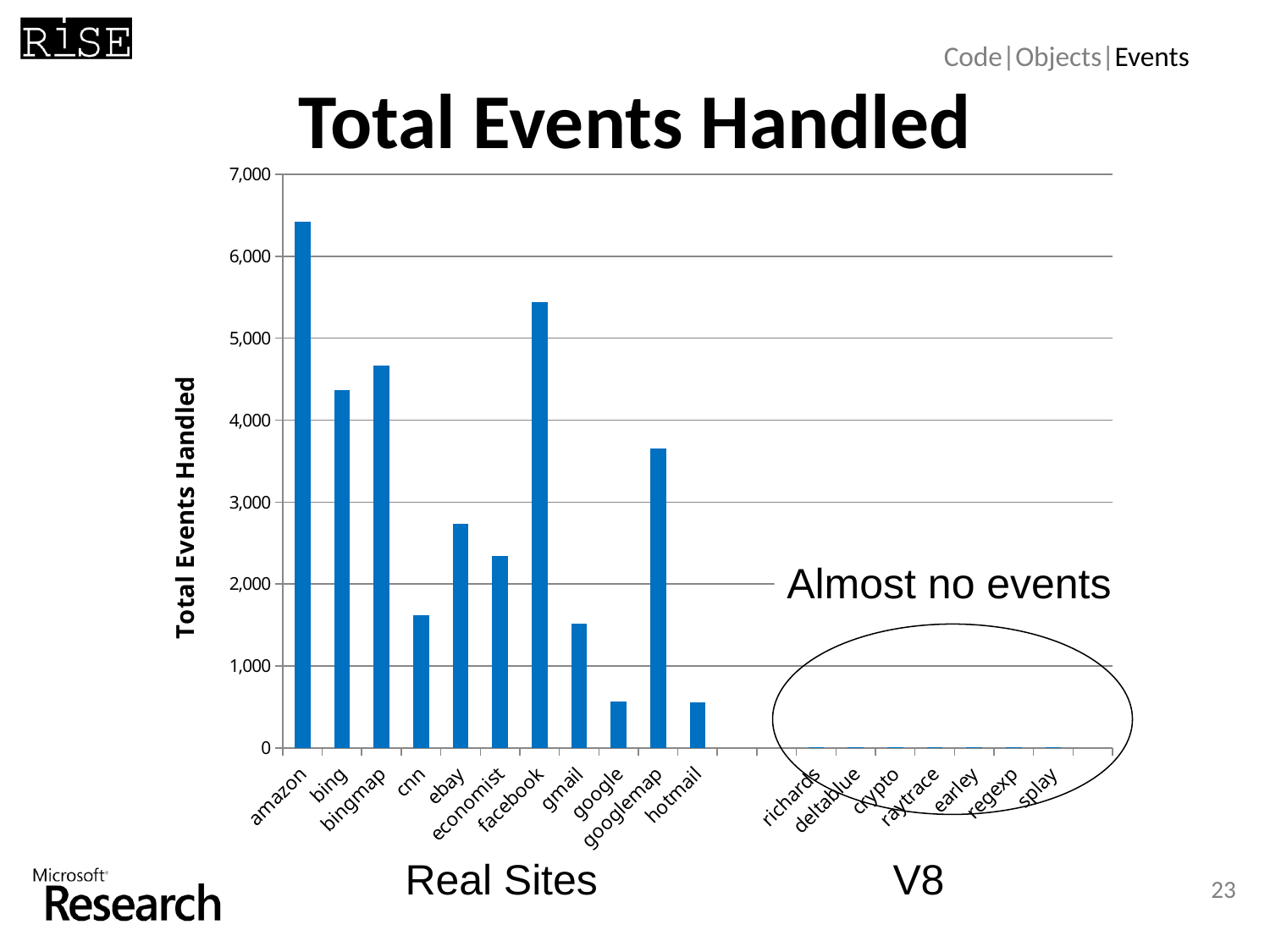
Is the value for google greater or less than 1,000? less Which category has the highest value in the Total Events Handled chart? amazon Which has a larger value, economist or gmail? economist Is the value for googlemap greater or less than 3,000? greater Is the value for amazon greater or less than 6,000? greater How many V8 benchmark categories (richards through splay) are labeled on the x axis? 7 Which has a larger value, bing or ebay? bing What is the title of the y axis? Total Events Handled What kind of chart is shown on the slide? bar chart What annotation text is written above the circled V8 group? Almost no events